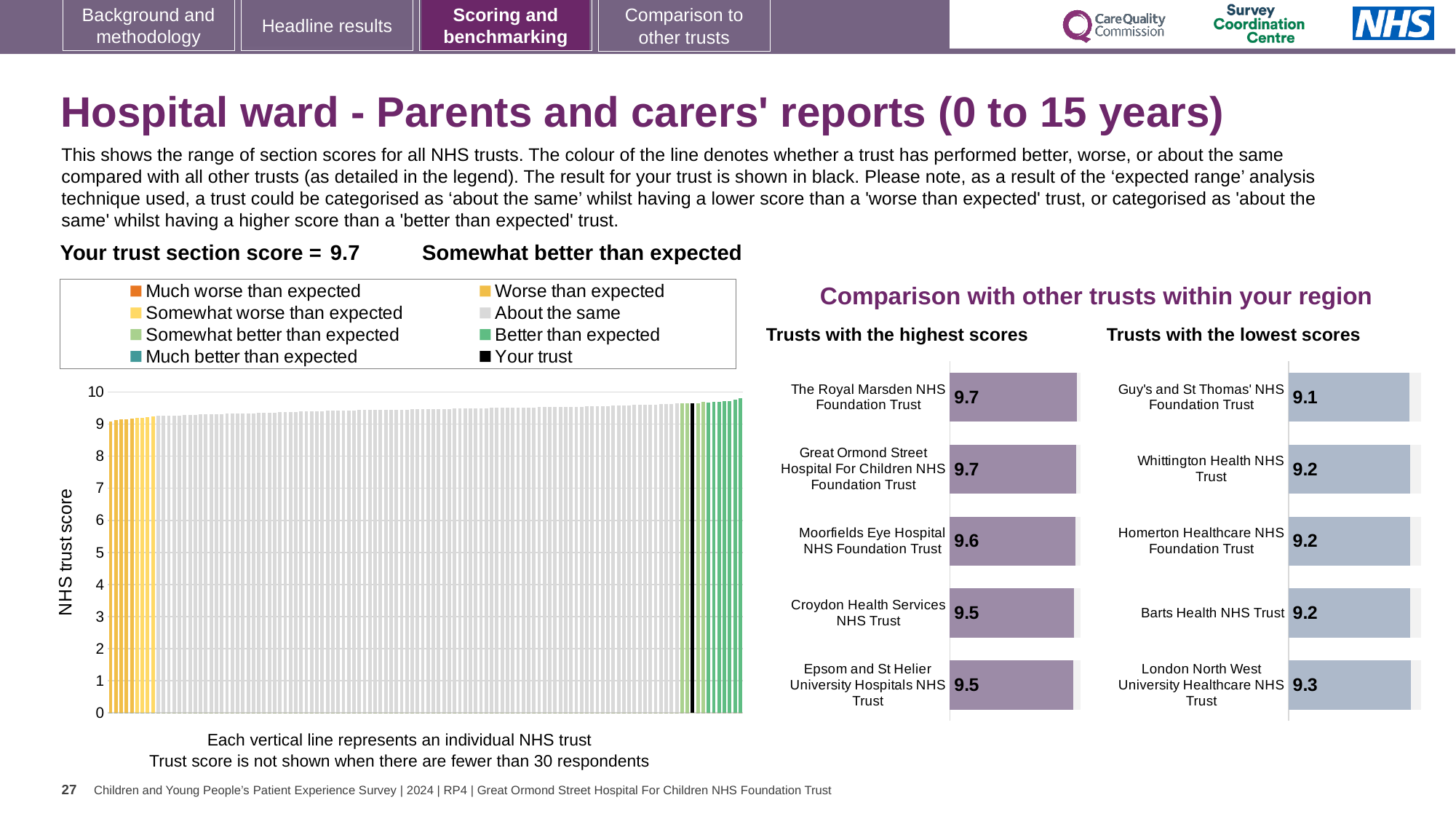
How many entries does the legend of the large chart on the left list? 8 In the large chart on the left, do the trust scores rise or fall from left to right along the x axis? rise Comparing the regional charts, which has the higher score: Moorfields Eye Hospital NHS Foundation Trust or Barts Health NHS Trust? Moorfields Eye Hospital NHS Foundation Trust What kind of chart is the large chart on the left showing NHS trust scores? bar chart How many trusts are shown in the 'Trusts with the highest scores' chart? 5 In the 'Trusts with the lowest scores' chart, what is the score for London North West University Healthcare NHS Trust? 9.3 In the 'Trusts with the lowest scores' chart, what is the score for Guy's and St Thomas' NHS Foundation Trust? 9.1 In the large chart on the left, is the value of the black bar (your trust) greater or less than 9? greater In the 'Trusts with the lowest scores' chart, what is the difference between the scores of London North West University Healthcare NHS Trust and Guy's and St Thomas' NHS Foundation Trust? 0.2 In the 'Trusts with the highest scores' chart, what is the score for Moorfields Eye Hospital NHS Foundation Trust? 9.6 In the 'Trusts with the lowest scores' chart, which trust has the lowest score? Guy's and St Thomas' NHS Foundation Trust In the 'Trusts with the highest scores' chart, what is the difference between the scores of The Royal Marsden NHS Foundation Trust and Croydon Health Services NHS Trust? 0.2